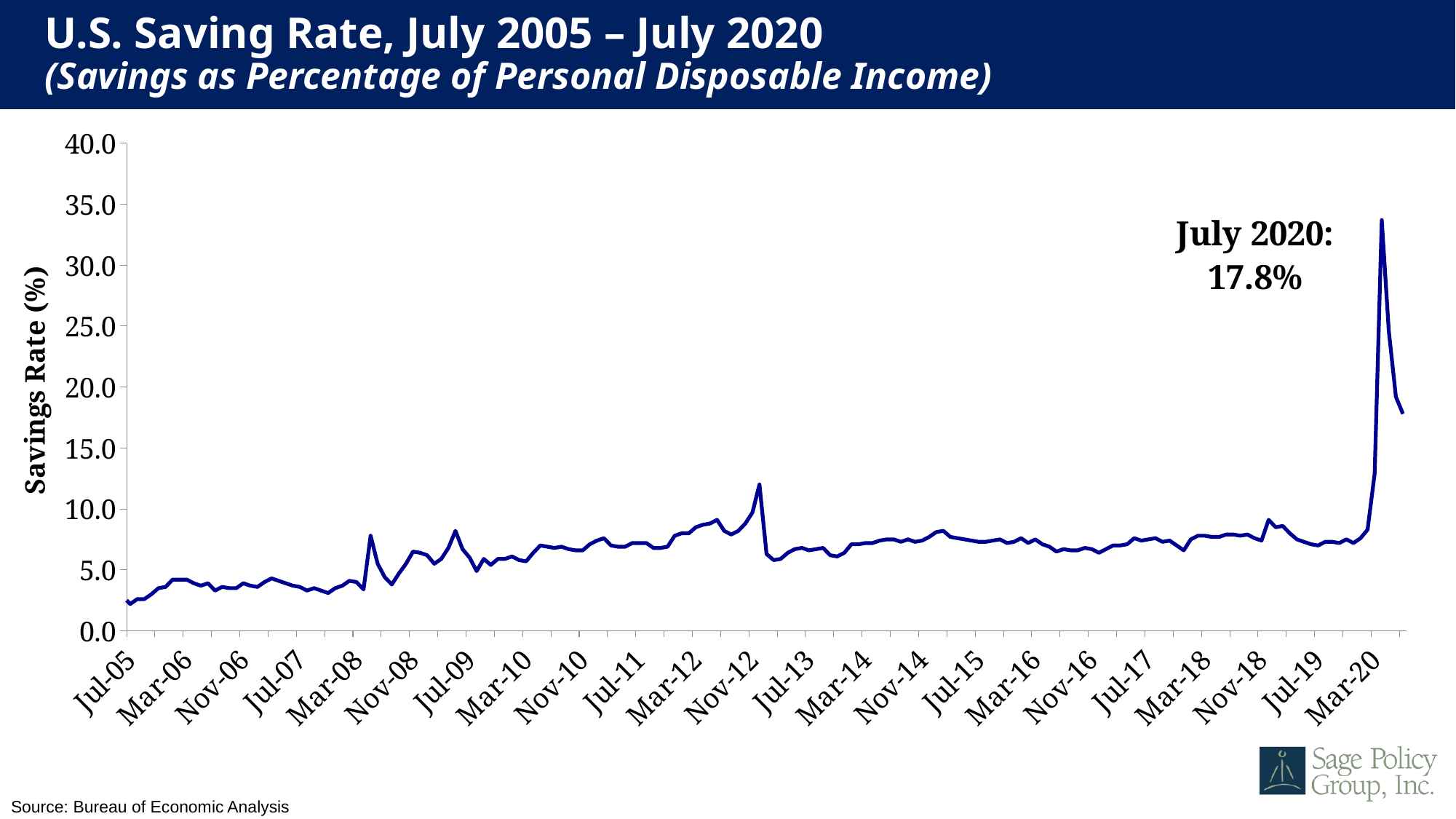
In which year does the saving rate reach its highest point on the chart? 2020 Is the value for Jul-17 greater or less than 5.0? greater What is the label on the vertical axis of the chart? Savings Rate (%) What kind of chart is shown on the slide? line chart Is the value for Jul-19 greater or less than 10.0? less Which is larger, the saving rate at Jul-05 or at July 2020? July 2020 Is the peak value reached in 2020 greater or less than 30.0? greater What source is cited for the chart data? Bureau of Economic Analysis How many data series are plotted on the chart? 1 What is the U.S. saving rate for July 2020 according to the label on the chart? 17.8% Does the saving rate rise or fall between its 2020 peak and July 2020? fall